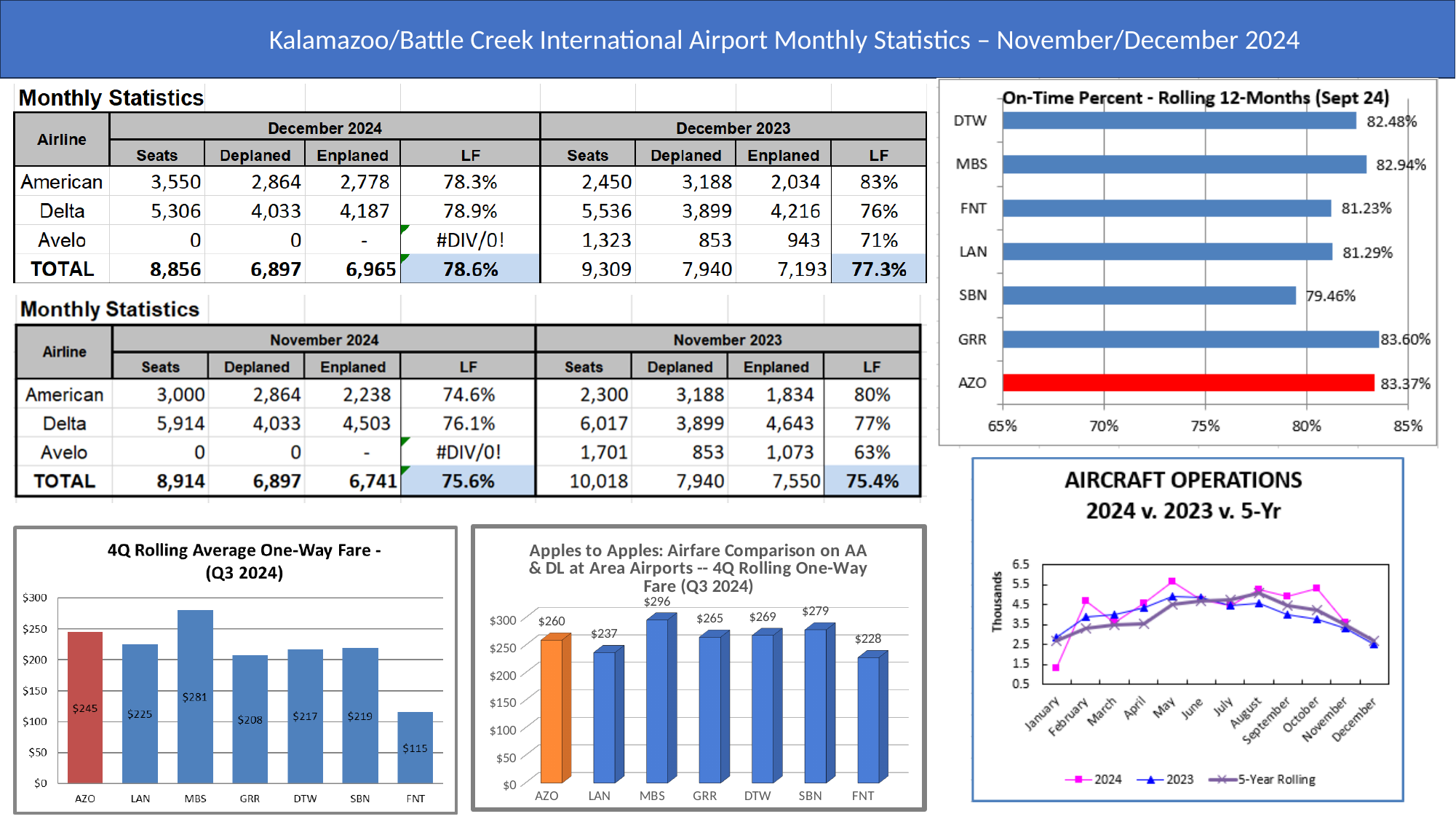
In the Apples to Apples airfare comparison chart, what is the fare for MBS? $296 In the Apples to Apples airfare comparison chart, which is larger, the fare for DTW or the fare for GRR? DTW In the 4Q Rolling Average One-Way Fare (Q3 2024) chart, which airport has the lowest fare? FNT In the 4Q Rolling Average One-Way Fare (Q3 2024) chart, what is the fare for AZO? $245 In the On-Time Percent - Rolling 12-Months (Sept 24) chart, which airport has the lowest on-time percent? SBN In the On-Time Percent - Rolling 12-Months (Sept 24) chart, what is the on-time percent for AZO? 83.37% In the On-Time Percent - Rolling 12-Months (Sept 24) chart, which airport has the highest on-time percent? GRR In the Apples to Apples airfare comparison chart, what is the difference between the MBS fare and the FNT fare? $68 What kind of chart is the Aircraft Operations 2024 v. 2023 v. 5-Yr chart? line chart In the Aircraft Operations 2024 v. 2023 v. 5-Yr chart, how many series does the legend list? 3 In the On-Time Percent - Rolling 12-Months (Sept 24) chart, how many airports are shown? 7 In the 4Q Rolling Average One-Way Fare (Q3 2024) chart, how much higher is the AZO fare than the LAN fare? $20